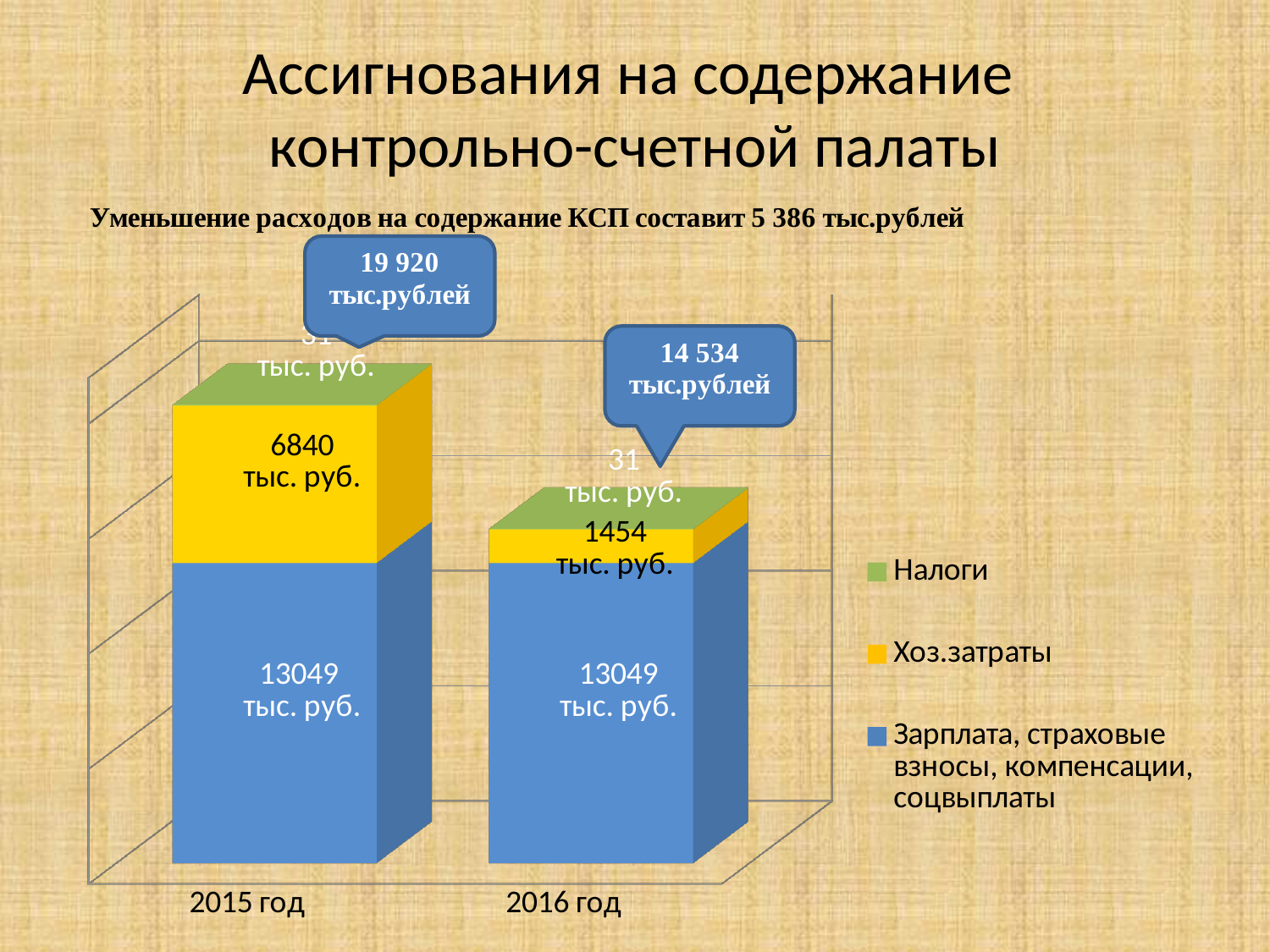
What is the value of Налоги for 2016 год? 31 тыс. руб. What is the total shown for the 2015 год bar? 19 920 тыс.рублей Which legend entry is shown in yellow? Хоз.затраты What is the value of Зарплата, страховые взносы, компенсации, соцвыплаты for 2016 год? 13049 тыс. руб. What is the total shown for the 2016 год bar? 14 534 тыс.рублей By how much does Хоз.затраты in 2015 год exceed Хоз.затраты in 2016 год? 5386 тыс. руб. What is the value of Хоз.затраты for 2015 год? 6840 тыс. руб. Which year has the larger total bar, 2015 год or 2016 год? 2015 год How many series does the legend list? 3 What is the value of Хоз.затраты for 2016 год? 1454 тыс. руб. What kind of chart is shown on the slide? Stacked bar chart How many categories (years) are shown on the x axis? 2